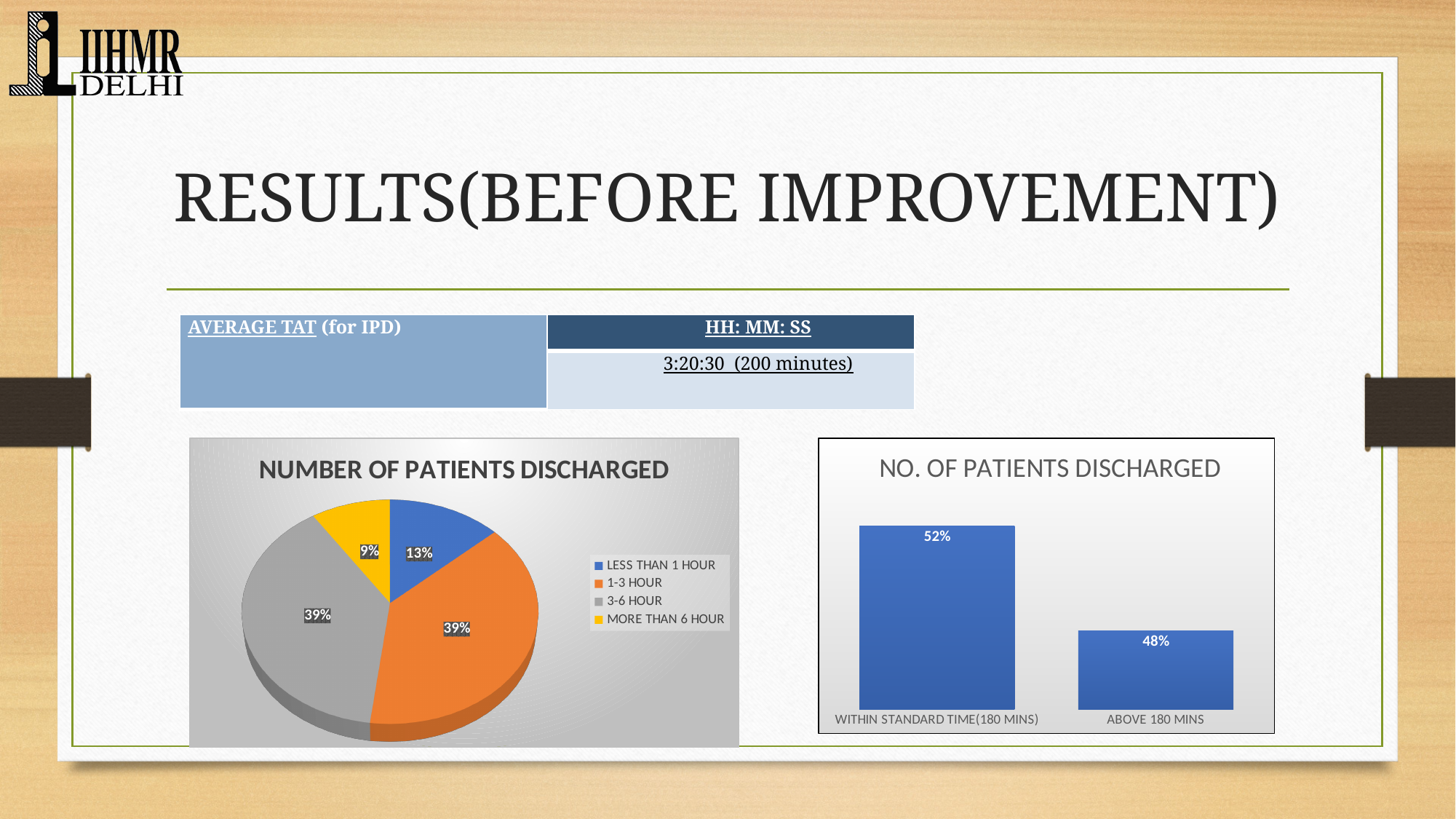
In the pie chart titled 'NUMBER OF PATIENTS DISCHARGED', which colour represents the 3-6 HOUR category? Grey In the bar chart titled 'NO. OF PATIENTS DISCHARGED', what is the value for WITHIN STANDARD TIME(180 MINS)? 52% In the bar chart titled 'NO. OF PATIENTS DISCHARGED', which category has the higher value? WITHIN STANDARD TIME(180 MINS) In the bar chart titled 'NO. OF PATIENTS DISCHARGED', what is the value for ABOVE 180 MINS? 48% What kind of chart is the one titled 'NO. OF PATIENTS DISCHARGED' on the right of the slide? Bar chart In the pie chart titled 'NUMBER OF PATIENTS DISCHARGED', which category has the smallest share? MORE THAN 6 HOUR In the pie chart titled 'NUMBER OF PATIENTS DISCHARGED', how many categories does the legend list? 4 In the pie chart titled 'NUMBER OF PATIENTS DISCHARGED', what share of patients were discharged in more than 6 hours? 9% In the pie chart titled 'NUMBER OF PATIENTS DISCHARGED', what share of patients were discharged in 1-3 hours? 39% In the pie chart titled 'NUMBER OF PATIENTS DISCHARGED', what share of patients were discharged in less than 1 hour? 13% In the pie chart titled 'NUMBER OF PATIENTS DISCHARGED', what is the difference between the share for LESS THAN 1 HOUR and the share for MORE THAN 6 HOUR? 4% In the bar chart titled 'NO. OF PATIENTS DISCHARGED', what is the difference between the two bars? 4%